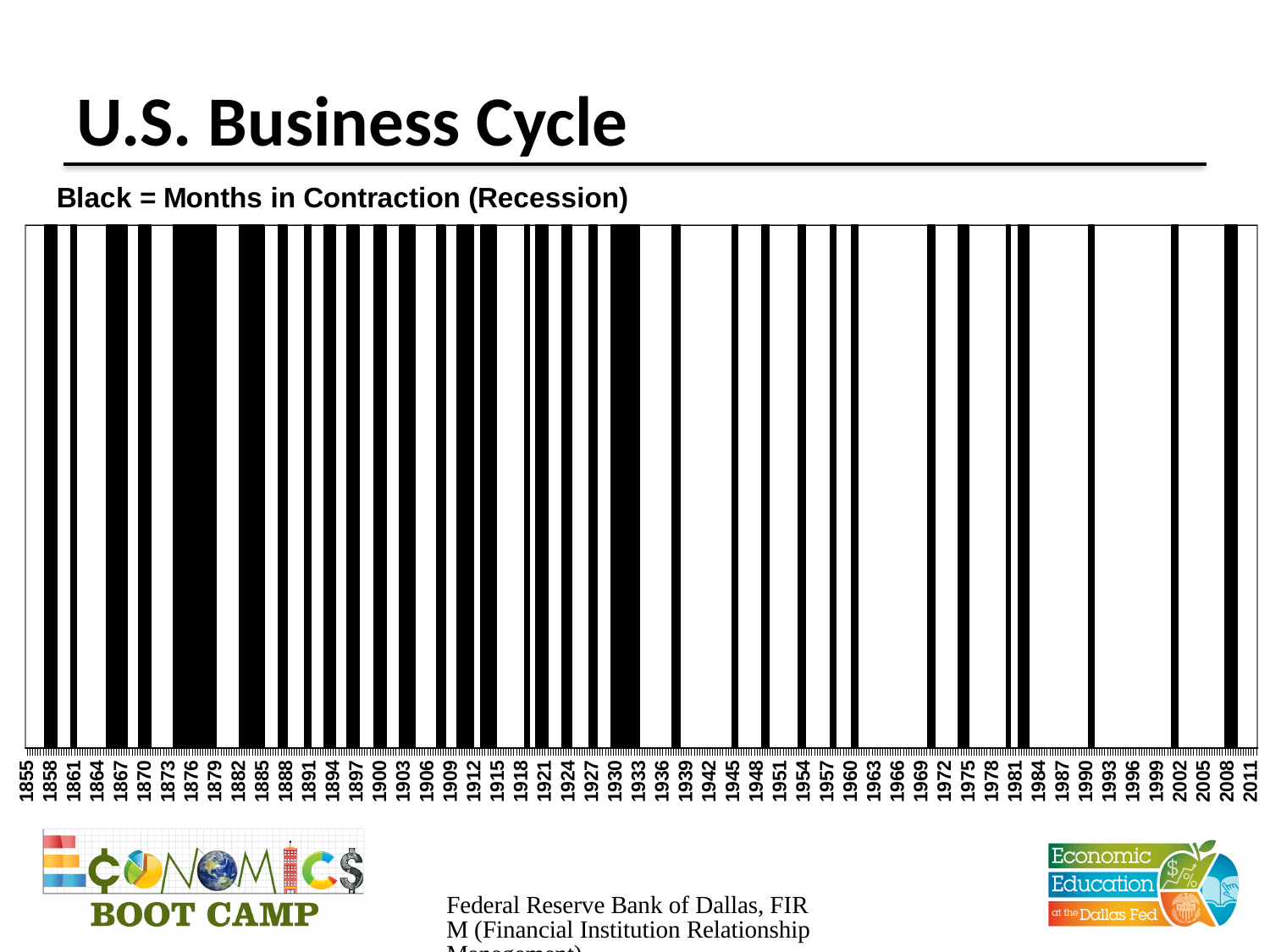
How many year labels are printed along the x axis? 53 What is the title of the chart? U.S. Business Cycle What kind of chart is shown on the slide? bar chart What is the earliest year label on the x axis? 1855 How many years apart are consecutive year labels on the x axis? 3 years Moving from left to right along the x axis, do the black contraction bars become more frequent or less frequent? less frequent What is the latest year label on the x axis? 2011 In which decade does the widest single black contraction bar appear? 1870s In which decade does the longest uninterrupted white (expansion) stretch appear? 1990s Is the period around 2008 shown as black (contraction) or white (expansion)? black (contraction) Is there more black (contraction) shading before 1933 or after 1933? before 1933 According to the slide, what do the black bars represent? Months in Contraction (Recession)